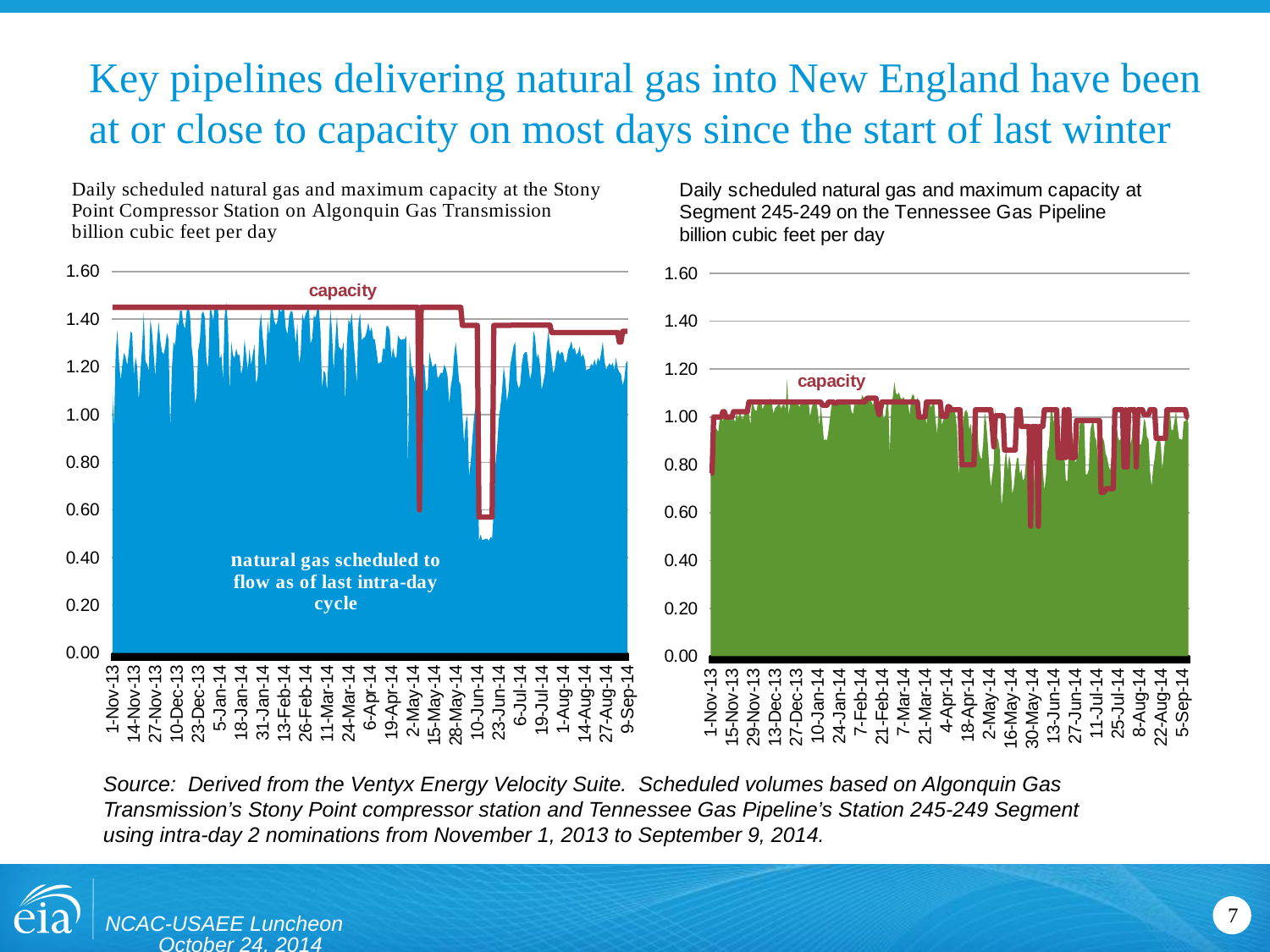
What is the maximum value shown on the y-axis of the right chart (Tennessee Gas Pipeline Segment 245-249)? 1.60 In the left chart (Stony Point Compressor Station), does the capacity line rise or fall between November 2013 and September 2014? fall In the left chart (Stony Point Compressor Station), is the capacity value at 1-Nov-13 greater or less than 1.20? greater What is the first date shown on the x-axis of the left chart (Stony Point Compressor Station)? 1-Nov-13 How many charts are shown on the slide? 2 What type of chart is the left chart, showing the Stony Point Compressor Station? combination area and line chart In the left chart (Stony Point Compressor Station), what two series are plotted? capacity and natural gas scheduled to flow as of last intra-day cycle In the right chart (Tennessee Gas Pipeline Segment 245-249), is the capacity value at 1-Nov-13 greater or less than 1.20? less What unit is used on the y-axis of both charts? billion cubic feet per day In the left chart (Stony Point Compressor Station), is the natural gas scheduled to flow at its lowest dip around 10-Jun-14 greater or less than 0.80? less Which chart has a higher capacity level during November 2013, the left chart (Stony Point) or the right chart (Tennessee Gas Pipeline Segment 245-249)? the left chart (Stony Point)